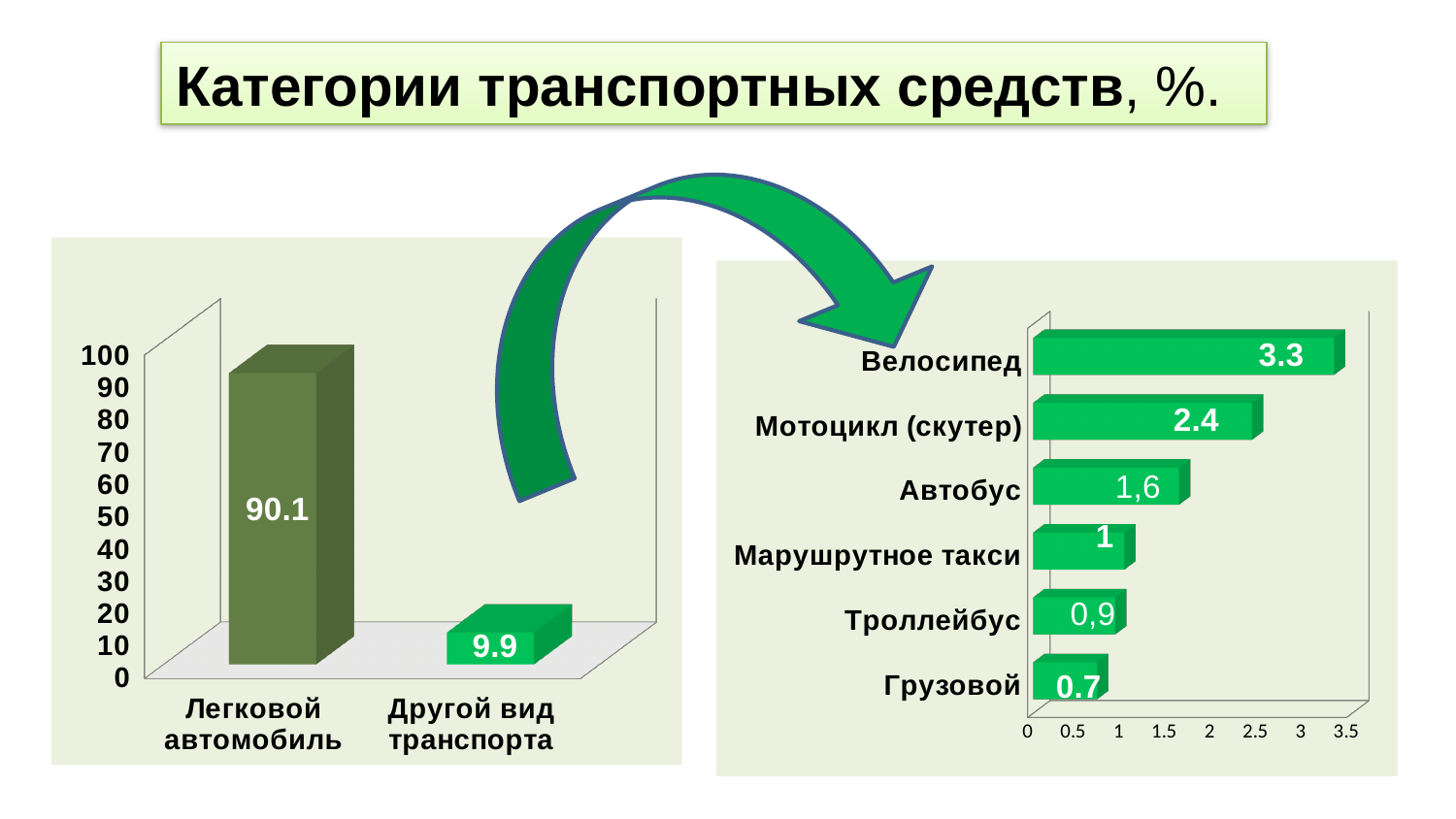
On the right chart, which category has the highest value? Велосипед On the right chart, which category has the lowest value? Грузовой On the right chart, what is the value for Мотоцикл (скутер)? 2.4 What kind of chart is the right chart? Bar chart How many categories does the left chart show? 2 On the right chart, what is the value for Велосипед? 3.3 On the right chart, what is the value for Троллейбус? 0,9 On the left chart, what is the value for Другой вид транспорта? 9.9 How many categories does the right chart show? 6 On the right chart, which is larger, the value for Автобус or the value for Маршрутное такси? Автобус On the left chart, what is the value for Легковой автомобиль? 90.1 On the left chart, what is the difference between the values for Легковой автомобиль and Другой вид транспорта? 80.2